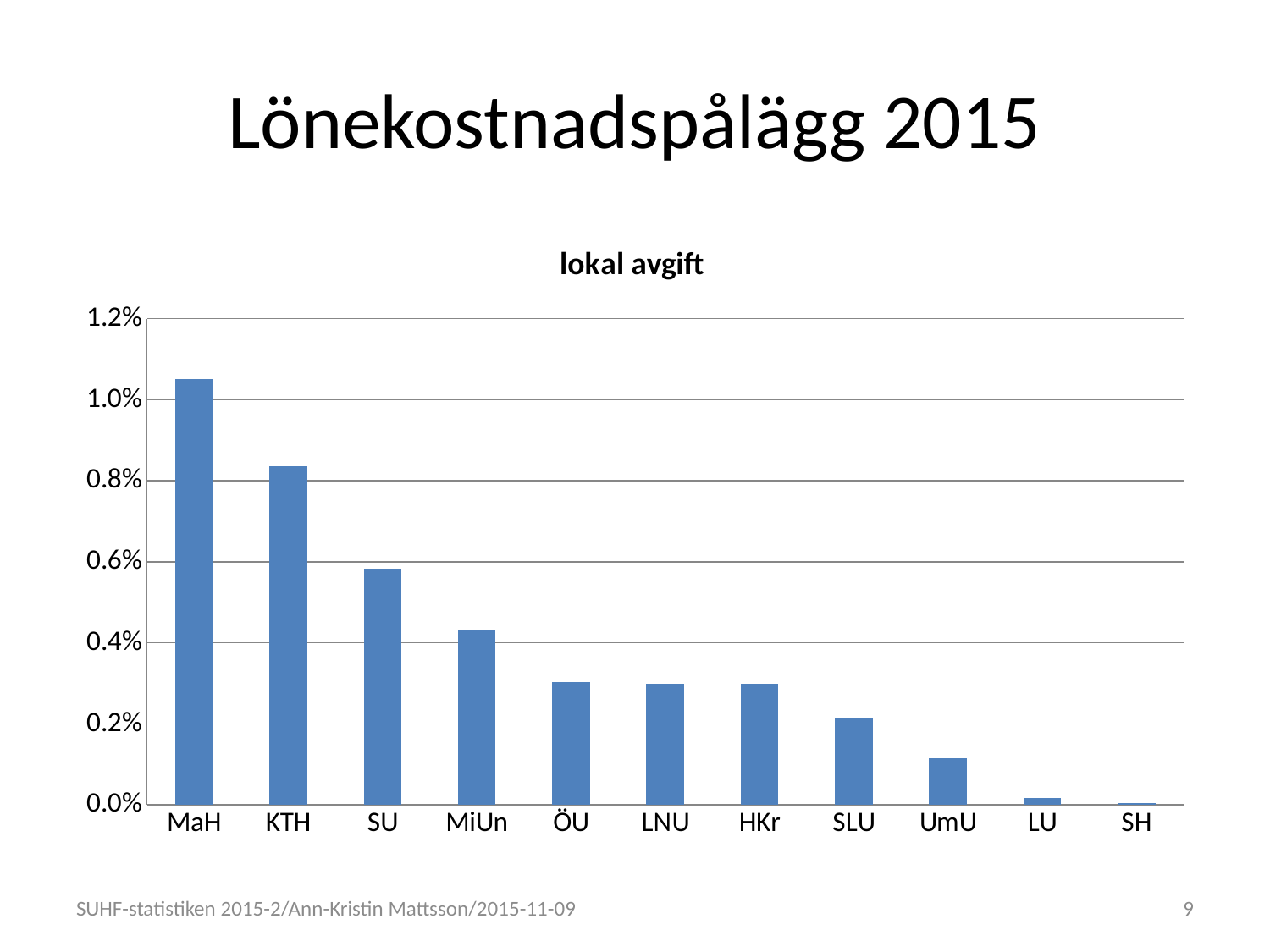
Which has a larger value, KTH or SU? KTH Which has a larger value, MiUn or SLU? MiUn Is the value for KTH greater or less than 0.8%? greater Do the values rise or fall moving from left to right along the x axis? fall Is the value for MaH greater or less than 1.0%? greater Is the value for UmU greater or less than 0.2%? less How many categories are shown on the x axis of the chart? 11 Which category has the lowest value in the chart? SH What is the title of the chart? lokal avgift Which category has the highest value in the chart? MaH What kind of chart is shown on the slide? bar chart